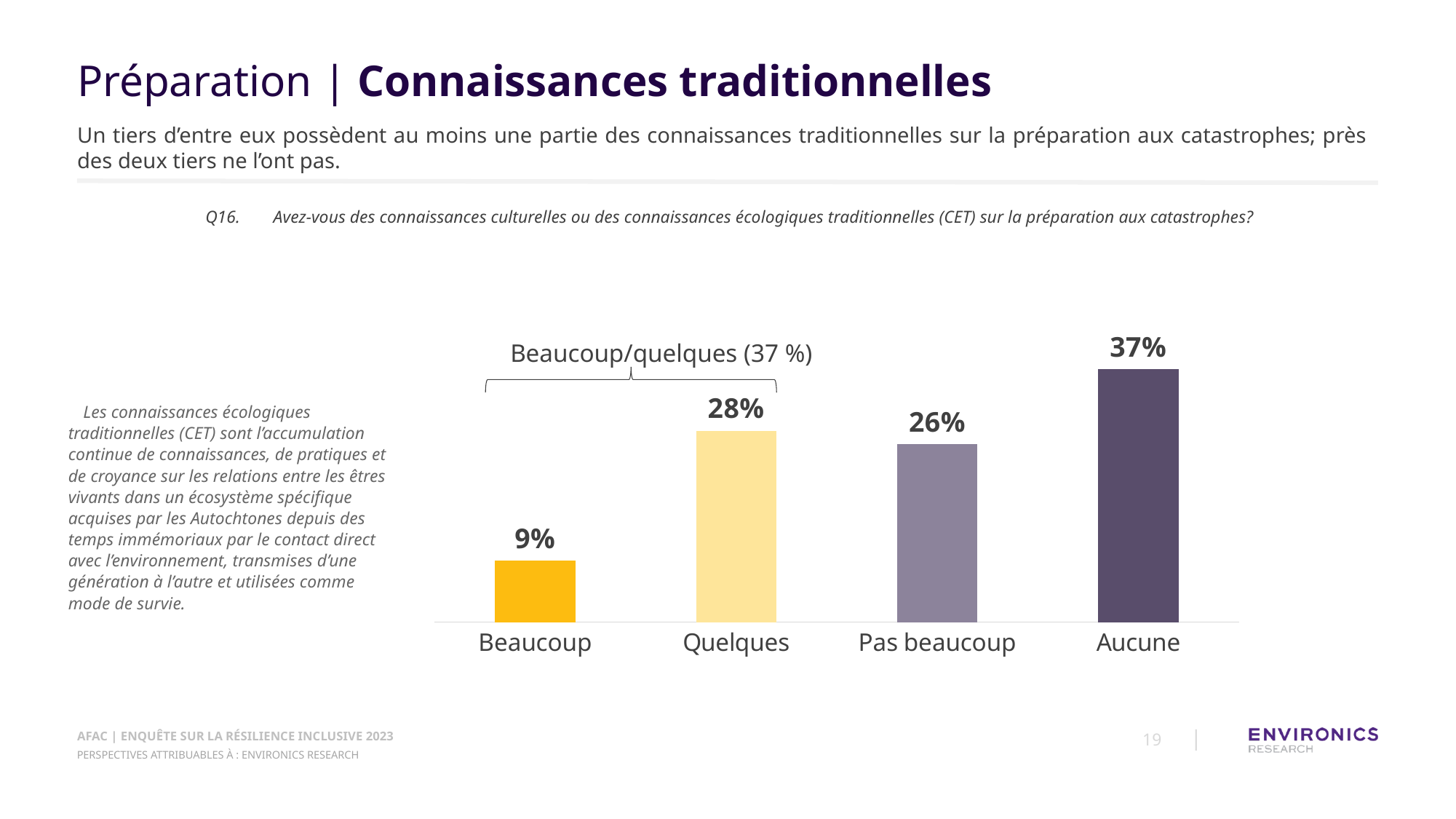
What kind of chart is shown on the slide? Bar chart What is the difference between the values for Aucune and Beaucoup? 28% What is the difference between the values for Quelques and Pas beaucoup? 2% Which category has the highest value? Aucune Which category has the lowest value? Beaucoup What is the value for Quelques? 28% Which is larger, the value for Quelques or the value for Beaucoup? Quelques What is the value for Beaucoup? 9% What is the value for Pas beaucoup? 26% What is the value for Aucune? 37% What combined percentage does the bracket above Beaucoup and Quelques show? 37 % How many categories are shown in the chart? 4